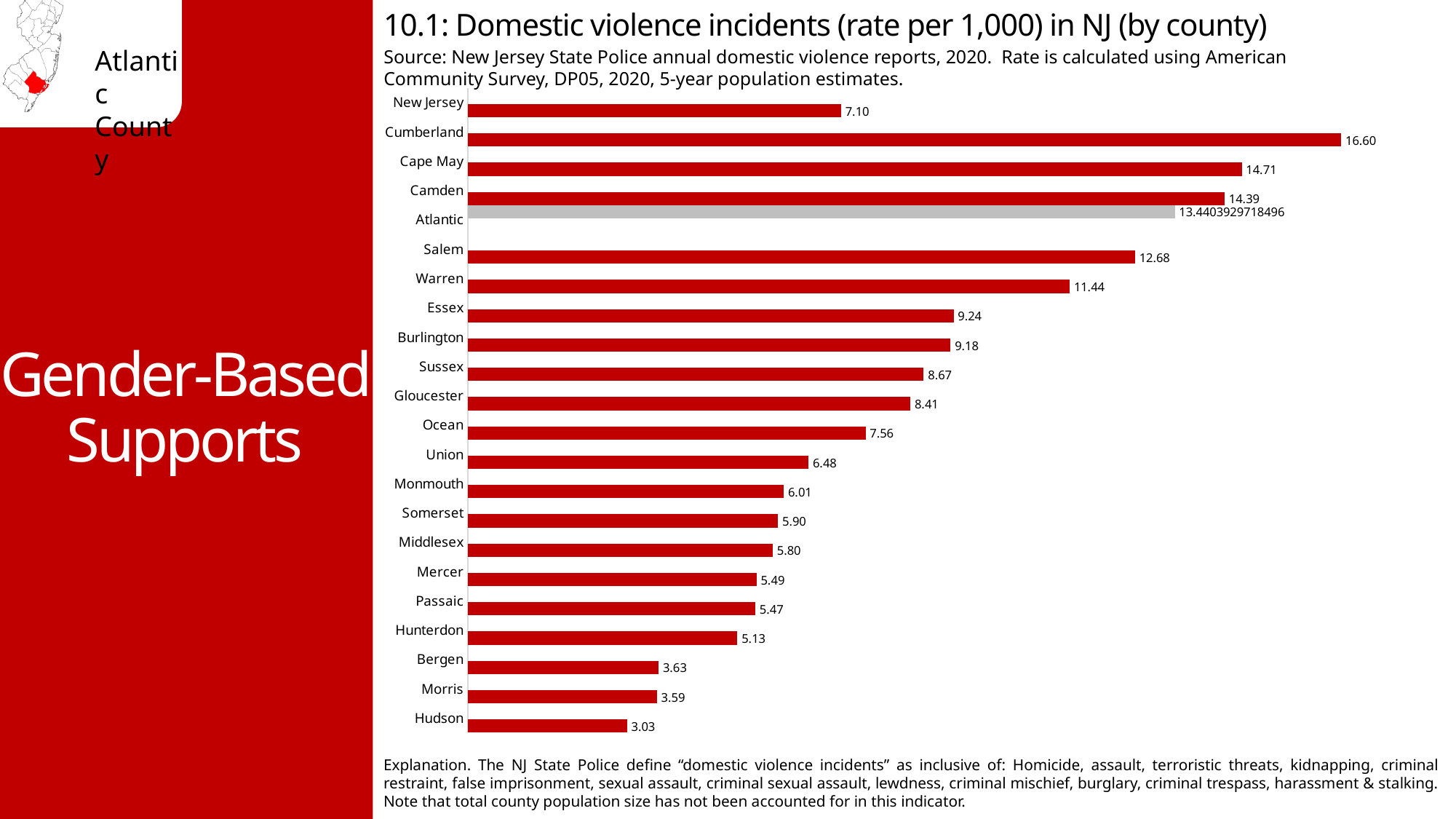
What is the domestic violence incident rate per 1,000 for Cumberland county? 16.60 How many bars are plotted in the chart? 22 Which has a higher rate, Salem or Warren? Salem What is the difference between the rates for Cumberland and Hudson? 13.57 What is the rate per 1,000 for Hunterdon county? 5.13 Which county has the highest domestic violence incident rate? Cumberland What is the domestic violence incident rate per 1,000 shown for New Jersey overall? 7.10 What value is labelled on the Atlantic county bar? 13.4403929718496 What is the difference between the rates for Cape May and Camden? 0.32 Which county's bar is shown in grey instead of red? Atlantic What type of chart is shown on the slide? Bar chart Which county has the lowest domestic violence incident rate? Hudson